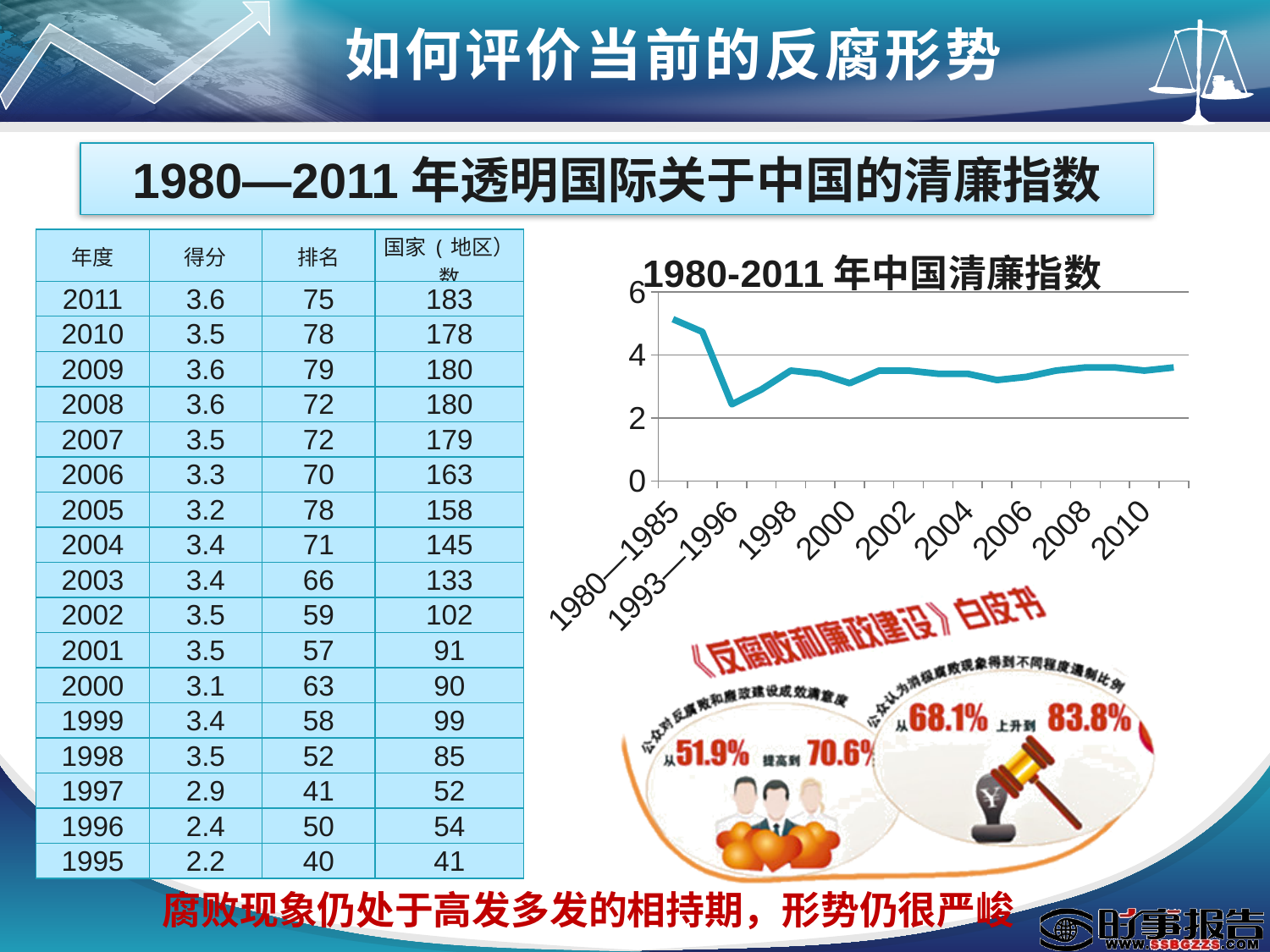
What is the highest value shown on the y axis? 6 Does the line overall rise or fall from 1980—1985 to 2010? fall Is the value for 2006 greater or less than 2? greater Is the value for 2000 greater or less than 4? less Which is larger, the value for 1980—1985 or the value for 2010? 1980—1985 Which labelled period on the x axis has the highest value? 1980—1985 What kind of chart is shown on the slide? line chart What is the title of the chart on the slide? 1980-2011 年中国清廉指数 Is the value for 1993—1996 greater or less than 4? less